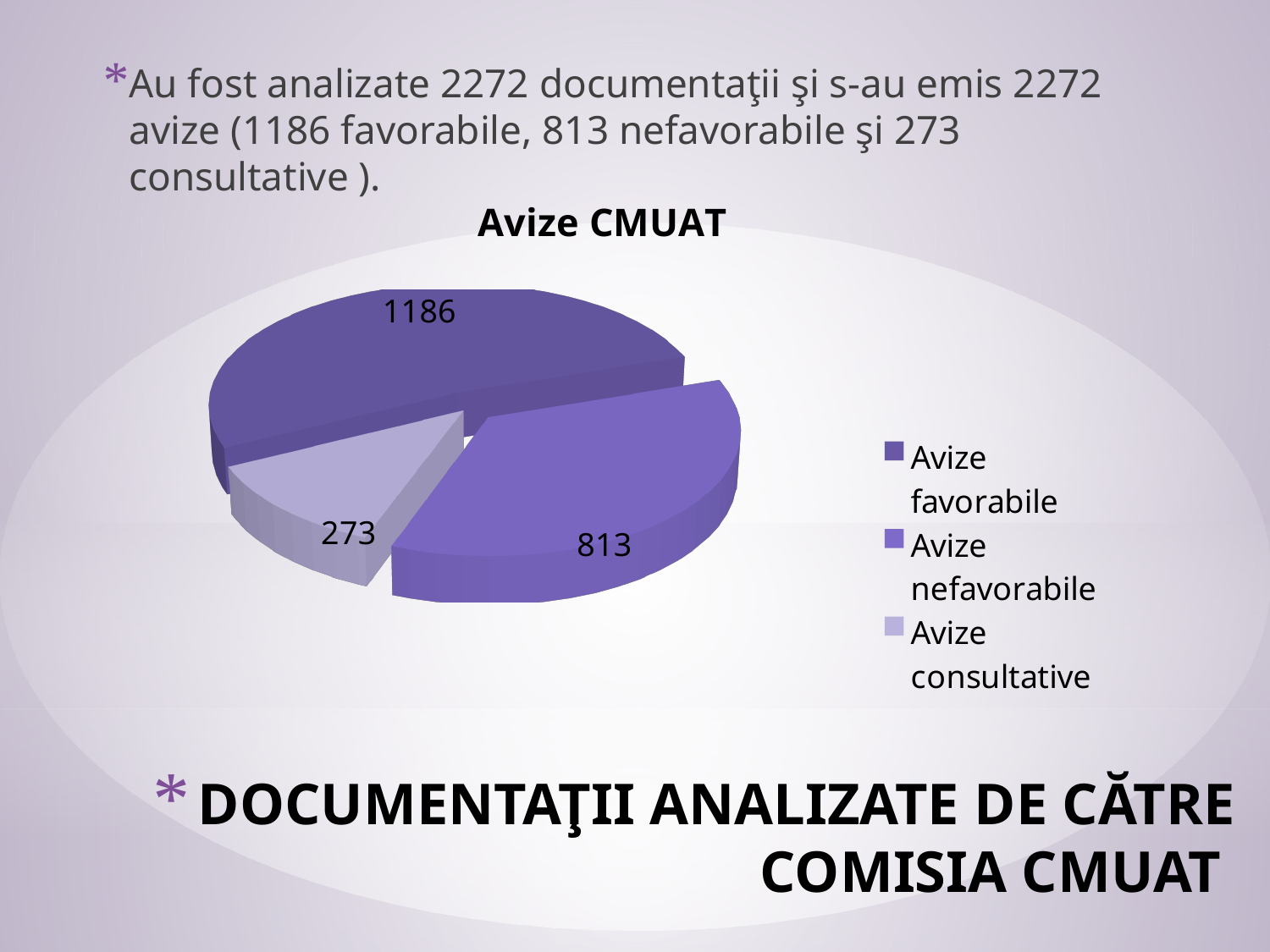
Which category has the smallest slice of the pie? Avize consultative What is the value for Avize favorabile? 1186 How many entries does the legend list? 3 What is the difference between Avize favorabile and Avize nefavorabile? 373 Which category has the largest slice of the pie? Avize favorabile Which is larger, Avize nefavorabile or Avize consultative? Avize nefavorabile What type of chart is shown on the slide? Pie chart What is the title of the chart? Avize CMUAT What is the value for Avize consultative? 273 What is the total of all three slices in the pie chart? 2272 How many slices does the pie chart have? 3 What is the value for Avize nefavorabile? 813